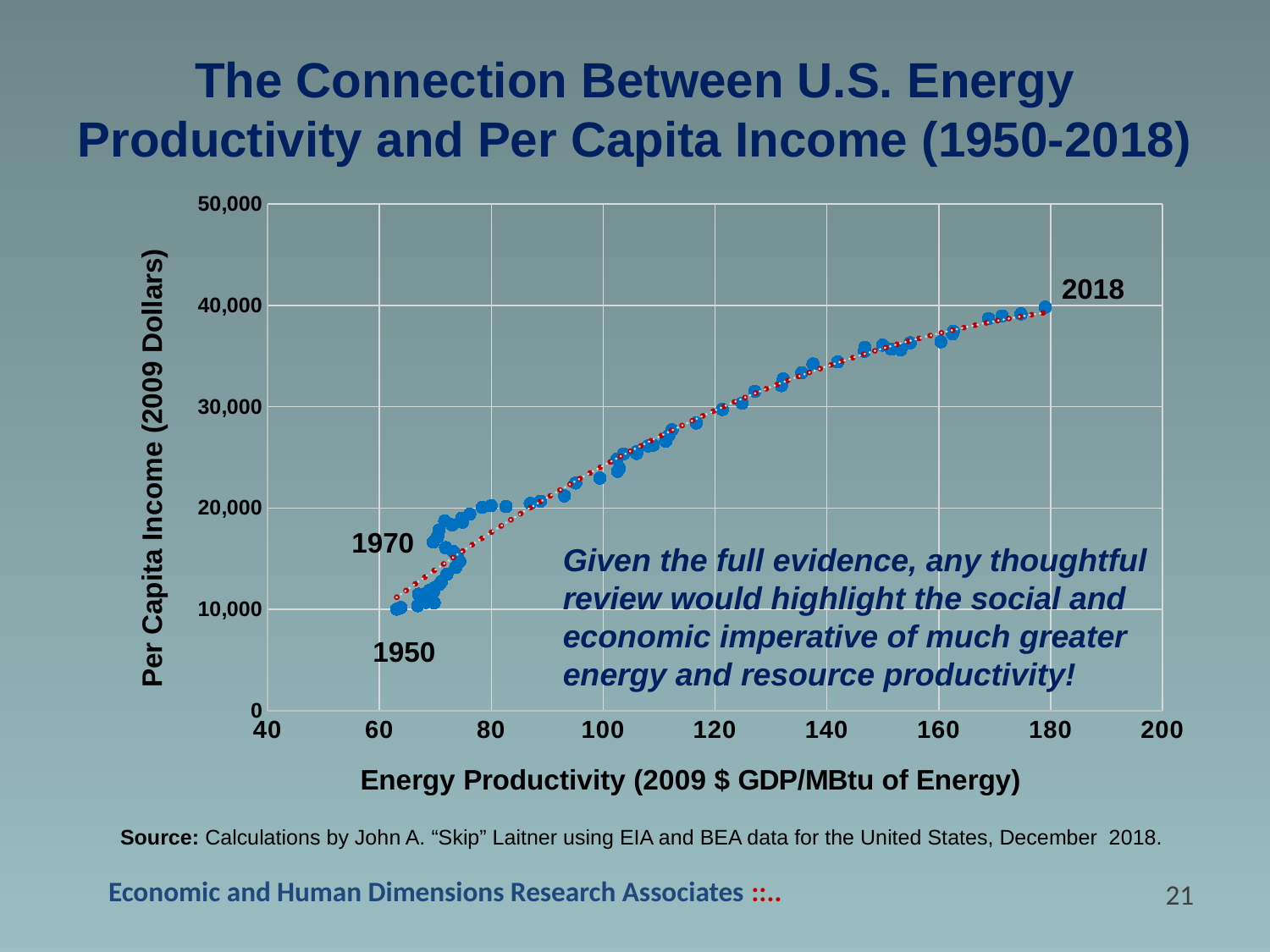
What is the title of the y axis? Per Capita Income (2009 Dollars) Which labeled year has the lower energy productivity, 1970 or 2018? 1970 Is the energy productivity for the point labeled 2018 greater or less than 160? greater How many years are labeled directly on the plotted points? 3 Is the energy productivity for the point labeled 1950 greater or less than 80? less As energy productivity increases along the x axis, does per capita income generally rise or fall? Rise Is the per capita income for the point labeled 2018 greater or less than 30,000? greater What is the title of the x axis? Energy Productivity (2009 $ GDP/MBtu of Energy) Which labeled year has the higher per capita income, 1950 or 2018? 2018 What kind of chart is shown on the slide? Scatter chart